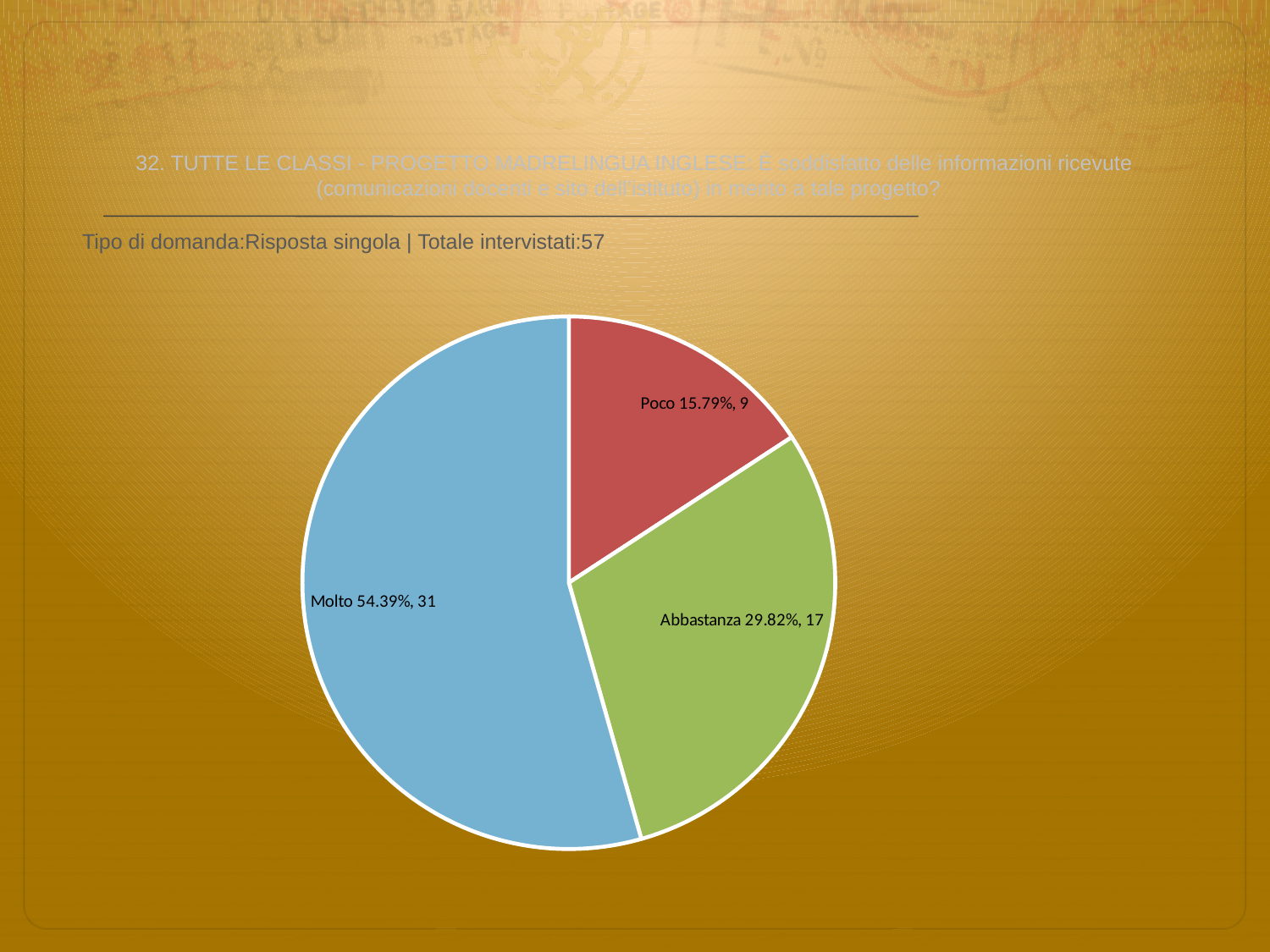
What kind of chart is shown on the slide? pie chart Which has more respondents, Abbastanza or Poco? Abbastanza How many respondents answered Molto? 31 What is the difference in respondent count between Molto and Abbastanza? 14 Which category has the smallest slice? Poco How many slices does the pie chart have? 3 How many respondents answered Abbastanza? 17 How many respondents answered Poco? 9 What percentage share does the Poco slice have? 15.79% What percentage share does the Molto slice have? 54.39% What percentage share does the Abbastanza slice have? 29.82% Which category has the largest slice? Molto